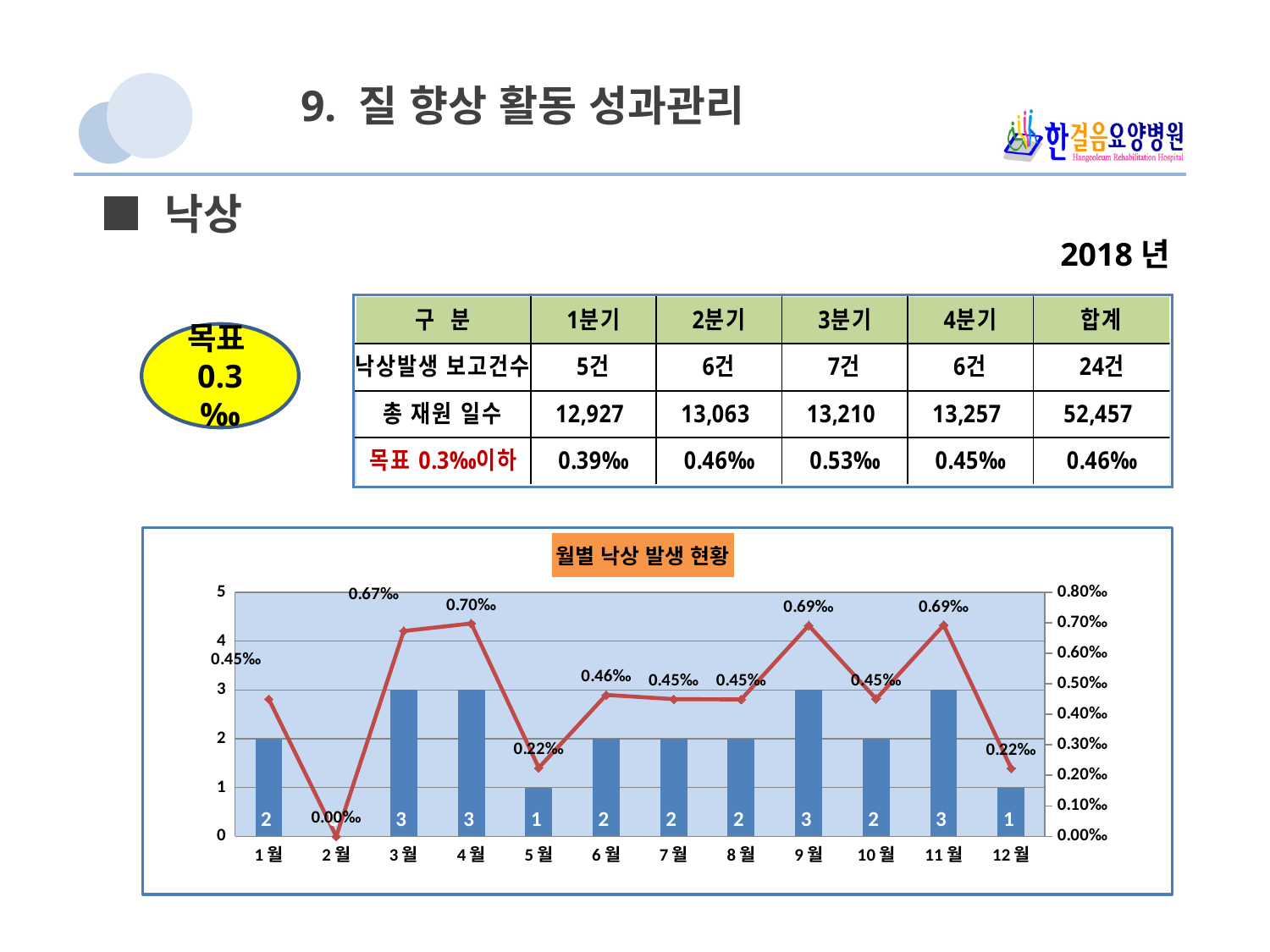
Is the line value for 6월 greater or less than 0.40‰? greater What is the title of the chart on the slide? 월별 낙상 발생 현황 How many months (categories) are shown on the x axis of the chart? 12 What kind of chart is shown on the slide? A combined bar and line chart What is the line value (rate) for 4월 in the chart? 0.70‰ What is the difference between the bar values for 9월 and 12월? 2 What is the line value (rate) for 2월 in the chart? 0.00‰ What is the bar value for 3월 in the chart? 3 Which month has the lowest bar value in the chart? 2월 What is the bar value for 5월 in the chart? 1 Which month has the highest line value (rate) in the chart? 4월 Which is larger, the line value for 9월 or the line value for 10월? 9월